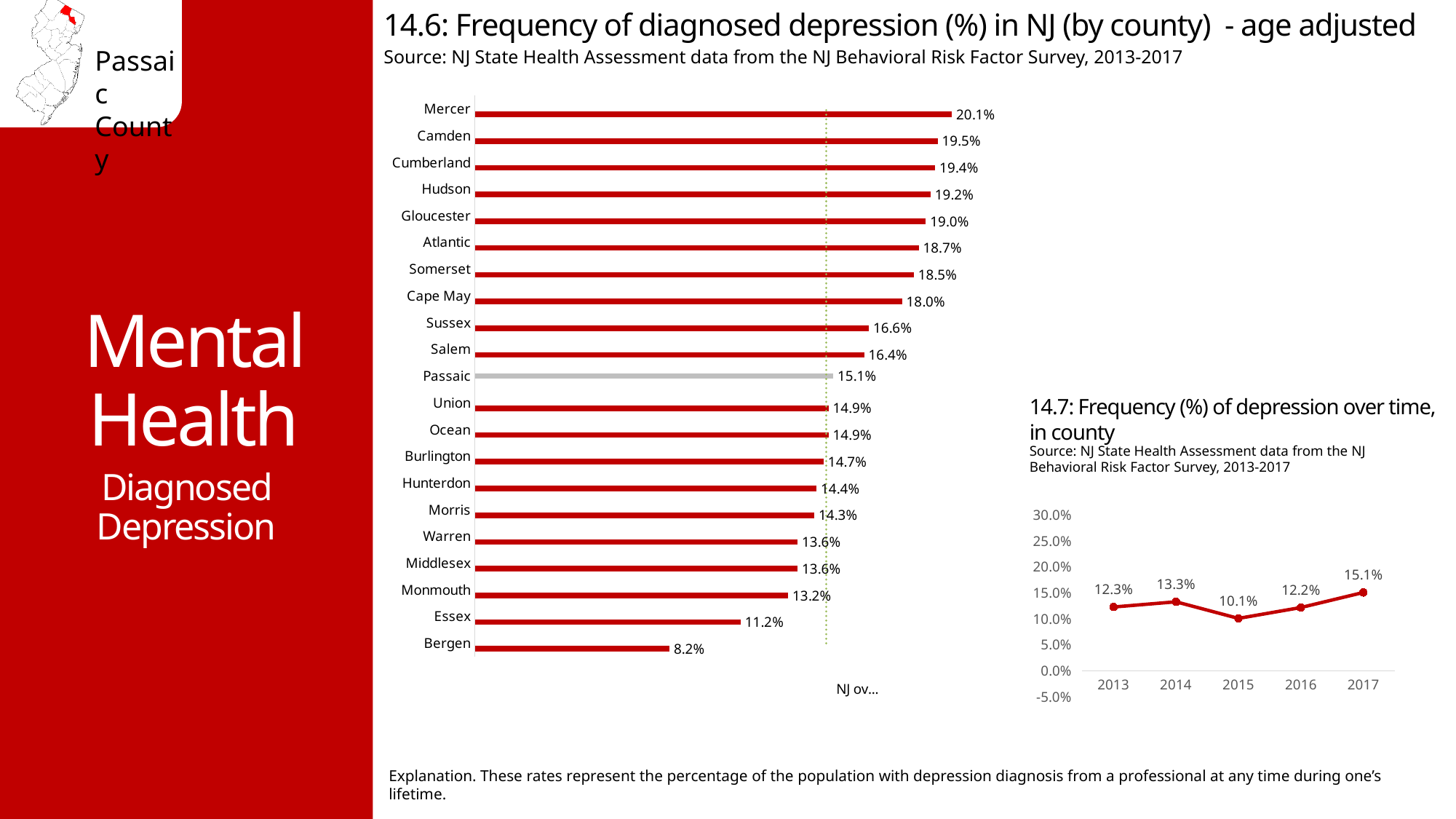
In chart 14.6 (frequency of diagnosed depression by county), how many counties are shown? 21 In chart 14.7 (frequency of depression over time), which year has the highest value? 2017 In chart 14.7 (frequency of depression over time), what is the difference between the 2017 and 2013 values? 2.8% In chart 14.6 (frequency of diagnosed depression by county), which county has the highest value? Mercer In chart 14.6 (frequency of diagnosed depression by county), what is the difference between Mercer and Bergen? 11.9% In chart 14.6 (frequency of diagnosed depression by county), what is the value for Essex? 11.2% What kind of chart is chart 14.7 (frequency of depression over time)? Line chart In chart 14.6 (frequency of diagnosed depression by county), what is the value for Passaic? 15.1% In chart 14.6 (frequency of diagnosed depression by county), which is larger, the value for Sussex or the value for Salem? Sussex In chart 14.7 (frequency of depression over time), what is the value for 2015? 10.1% What kind of chart is chart 14.6 (frequency of diagnosed depression by county)? Bar chart In chart 14.6 (frequency of diagnosed depression by county), which county has the lowest value? Bergen